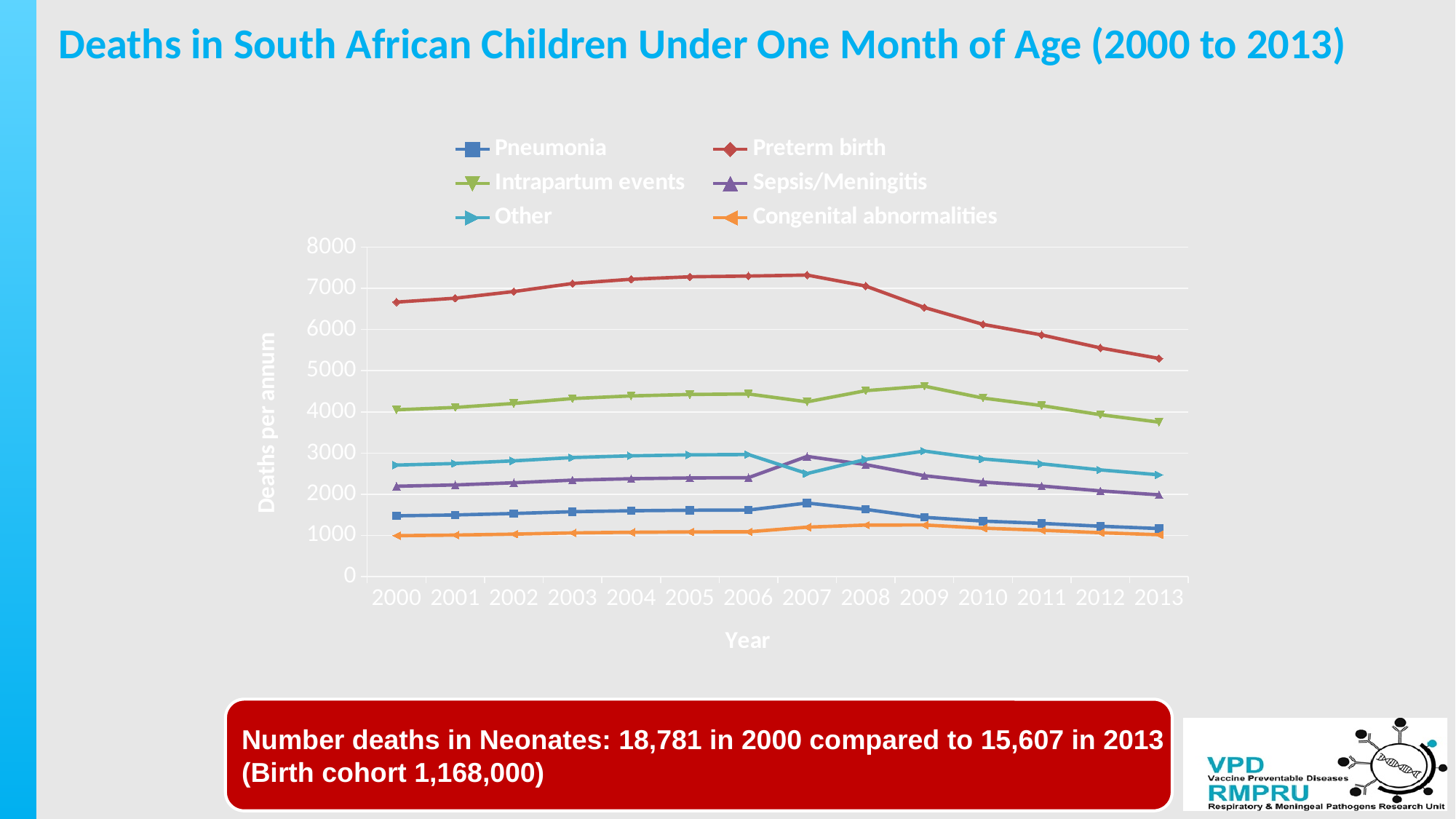
How does the Preterm birth line change from 2007 to 2013? It falls What is the label on the y axis? Deaths per annum In 2007, which is larger: Sepsis/Meningitis or Other? Sepsis/Meningitis How many years are plotted along the x axis? 14 Which cause of death has the highest values across the whole period? Preterm birth How many series does the legend list? 6 Which cause of death has the lowest values across the whole period? Congenital abnormalities Is the value for Preterm birth in 2013 greater or less than 6000? less Is the value for Intrapartum events in 2009 greater or less than 4000? greater Is the value for Pneumonia in 2000 greater or less than 2000? less What kind of chart is shown on the slide? Line chart